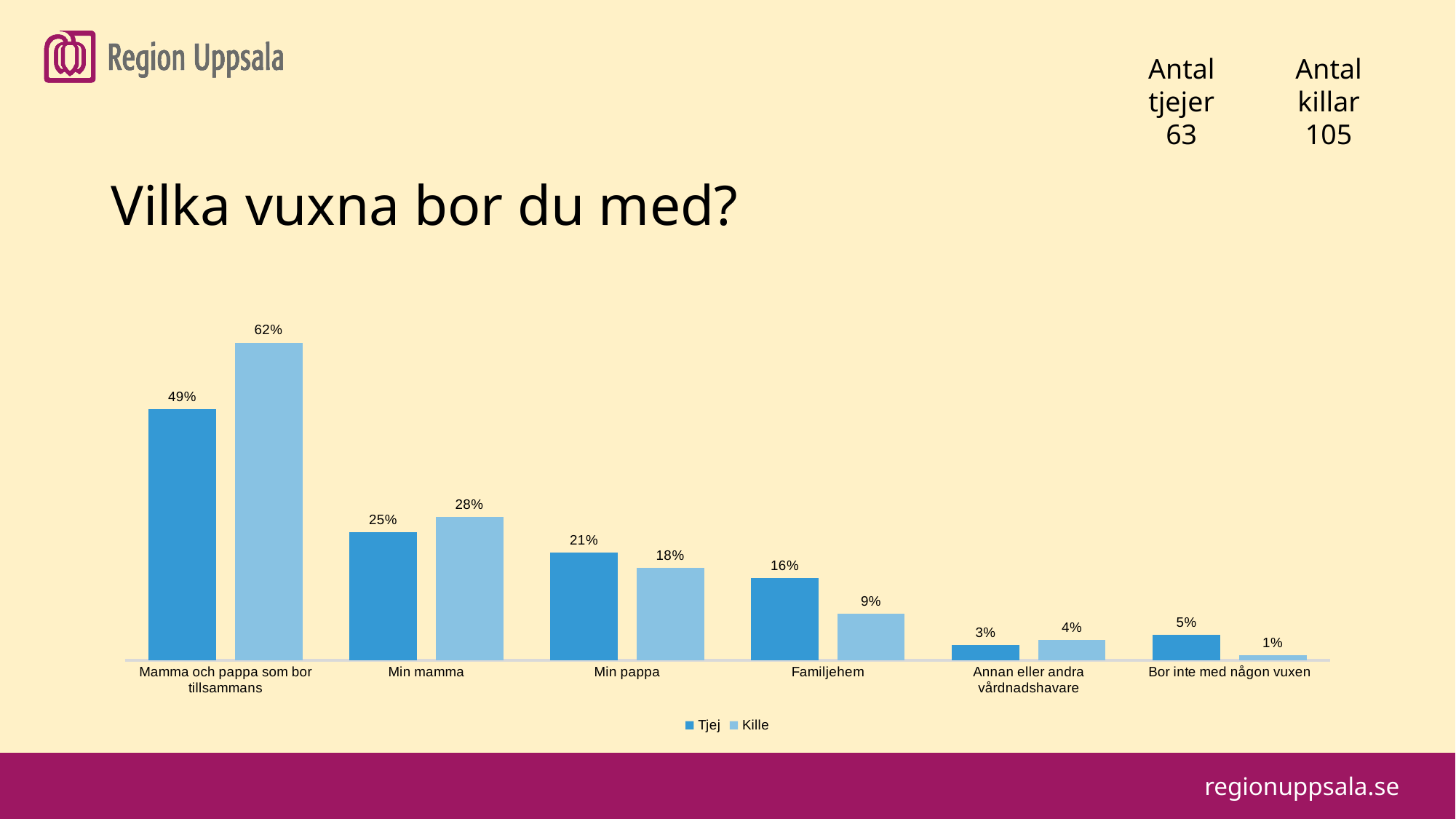
Which category has the lowest value for Kille? Bor inte med någon vuxen How many categories are shown on the x axis? 6 Which is larger for "Familjehem": the Tjej value or the Kille value? Tjej What is the difference between the Kille and Tjej values for "Mamma och pappa som bor tillsammans"? 13% Which category has the highest value for Kille? Mamma och pappa som bor tillsammans What are the names of the two series in the legend? Tjej and Kille What is the value for Tjej in the category "Mamma och pappa som bor tillsammans"? 49% Which category has the lowest value for Tjej? Annan eller andra vårdnadshavare How many series does the legend list? 2 What is the value for Kille in the category "Min pappa"? 18% What is the value for Tjej in the category "Familjehem"? 16% What kind of chart is shown on the slide? Bar chart